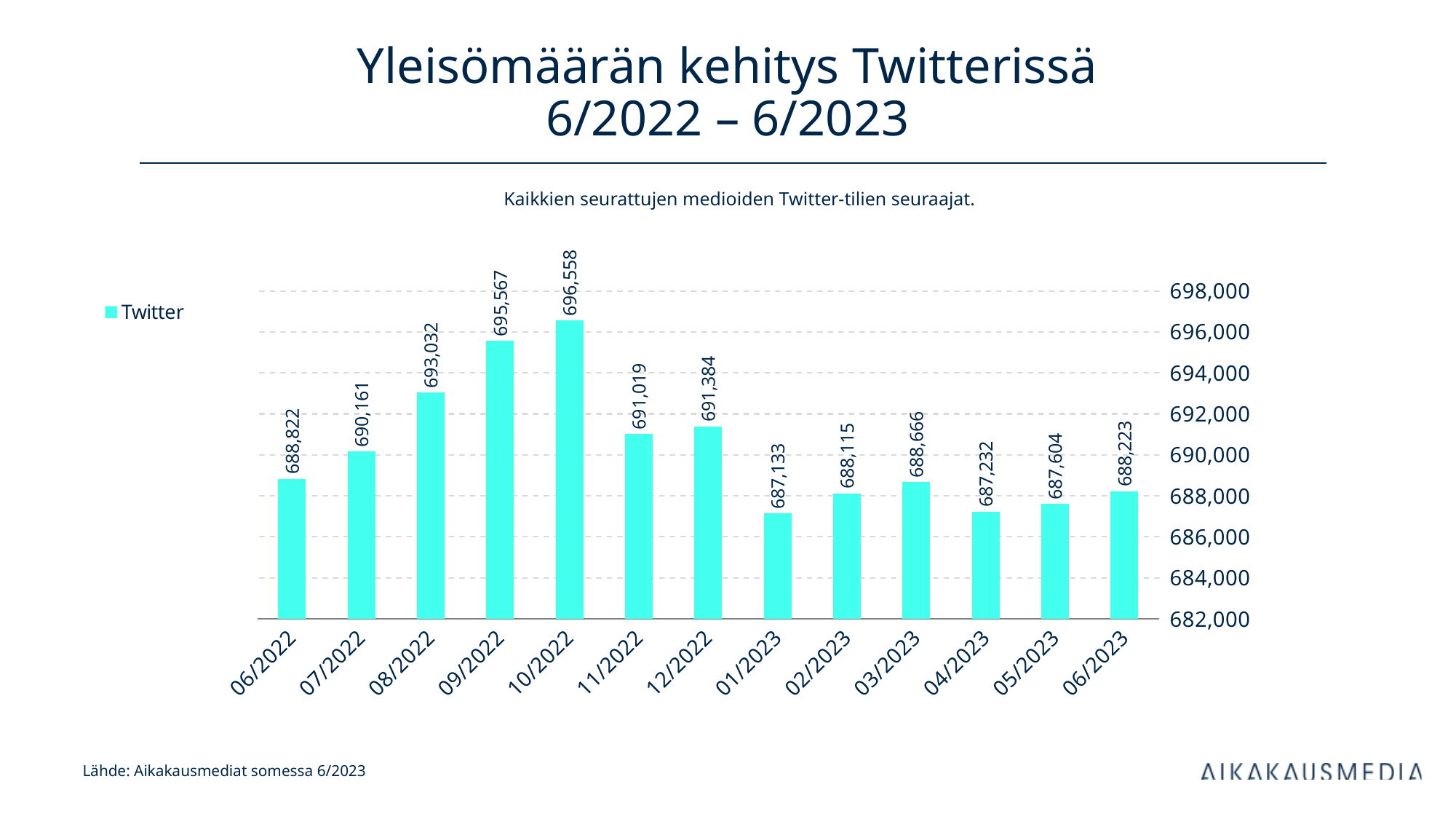
What is the value for 01/2023? 687,133 How many series does the legend list? 1 What is the value for 06/2023? 688,223 Which is larger, the value for 11/2022 or the value for 12/2022? 12/2022 What is the value for 10/2022? 696,558 What kind of chart is shown on the slide? bar chart What is the difference between the values for 10/2022 and 06/2022? 7,736 How many months are shown on the x axis? 13 Which month has the highest value? 10/2022 Is the value for 09/2022 greater or less than 694,000? greater What is the difference between the values for 06/2022 and 06/2023? 599 Which month has the lowest value? 01/2023